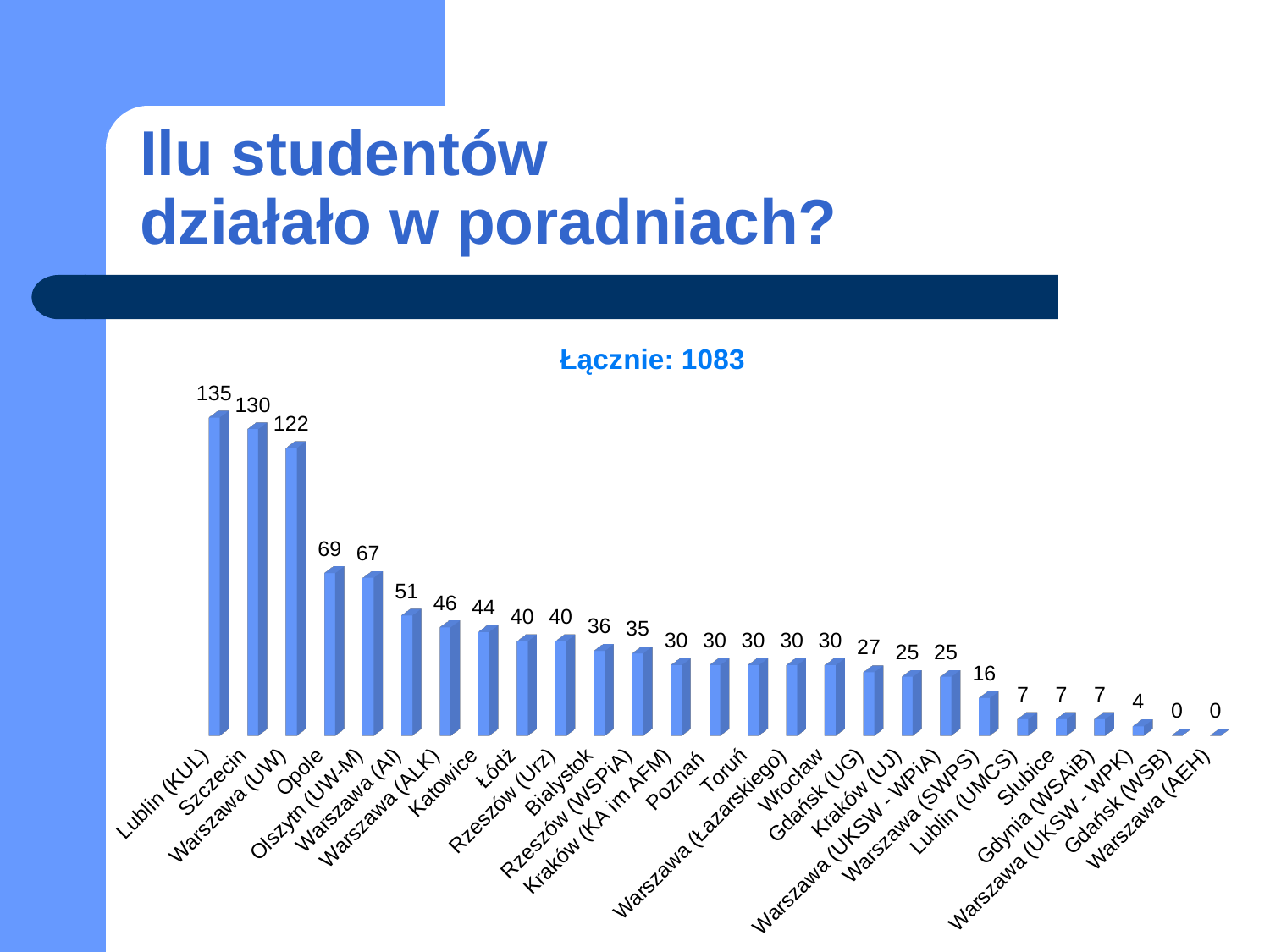
How many students are shown for Lublin (KUL)? 135 What is the title of the slide? Ilu studentów działało w poradniach? What is the value for Opole? 69 What is the lowest value shown in the chart? 0 Which category has the highest value? Lublin (KUL) Which is larger, the value for Katowice or the value for Białystok? Katowice What is the difference between the values for Szczecin and Warszawa (UW)? 8 How many categories are shown in the chart? 27 What is the value for Warszawa (SWPS)? 16 What is the value for Gdańsk (UG)? 27 What total is stated above the chart (Łącznie)? 1083 What kind of chart is shown on the slide? bar chart